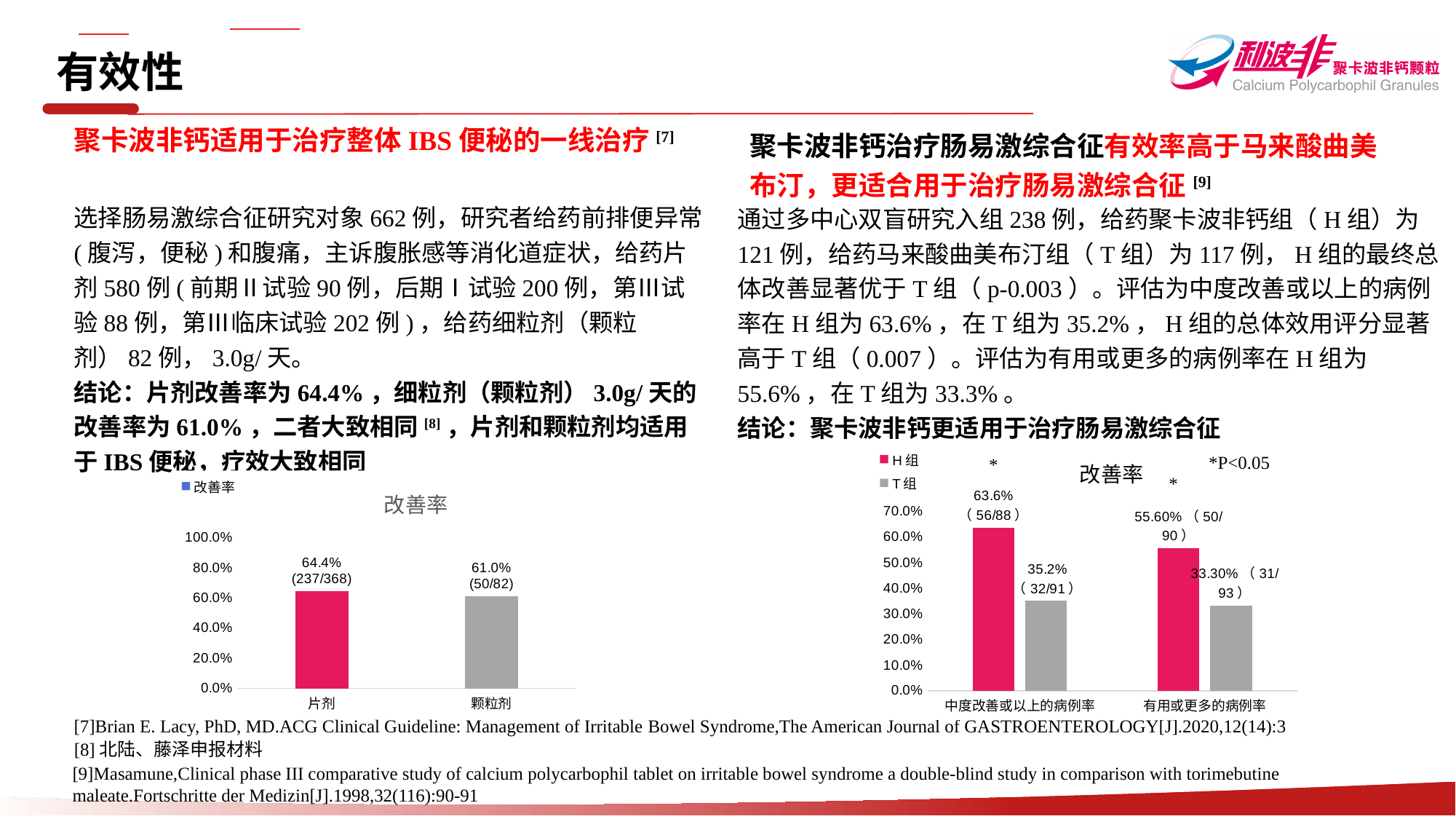
In the right chart, what is the difference between H 组 and T 组 for 中度改善或以上的病例率? 28.4% In the left chart, what is the value for 颗粒剂? 61.0% What kind of chart is the left chart? bar chart In the right chart, what colour are the bars for H 组? red In the left chart, which category has the higher value? 片剂 In the right chart, what is the value for H 组 in 中度改善或以上的病例率? 63.6% In the right chart, which series has the larger value for 有用或更多的病例率, H 组 or T 组? H 组 In the left chart, what is the value for 片剂? 64.4% In the right chart, what is the value for T 组 in 有用或更多的病例率? 33.30% In the left chart, how many categories are shown on the x axis? 2 In the left chart, what is the difference between the values for 片剂 and 颗粒剂? 3.4% In the right chart, how many series does the legend list? 2